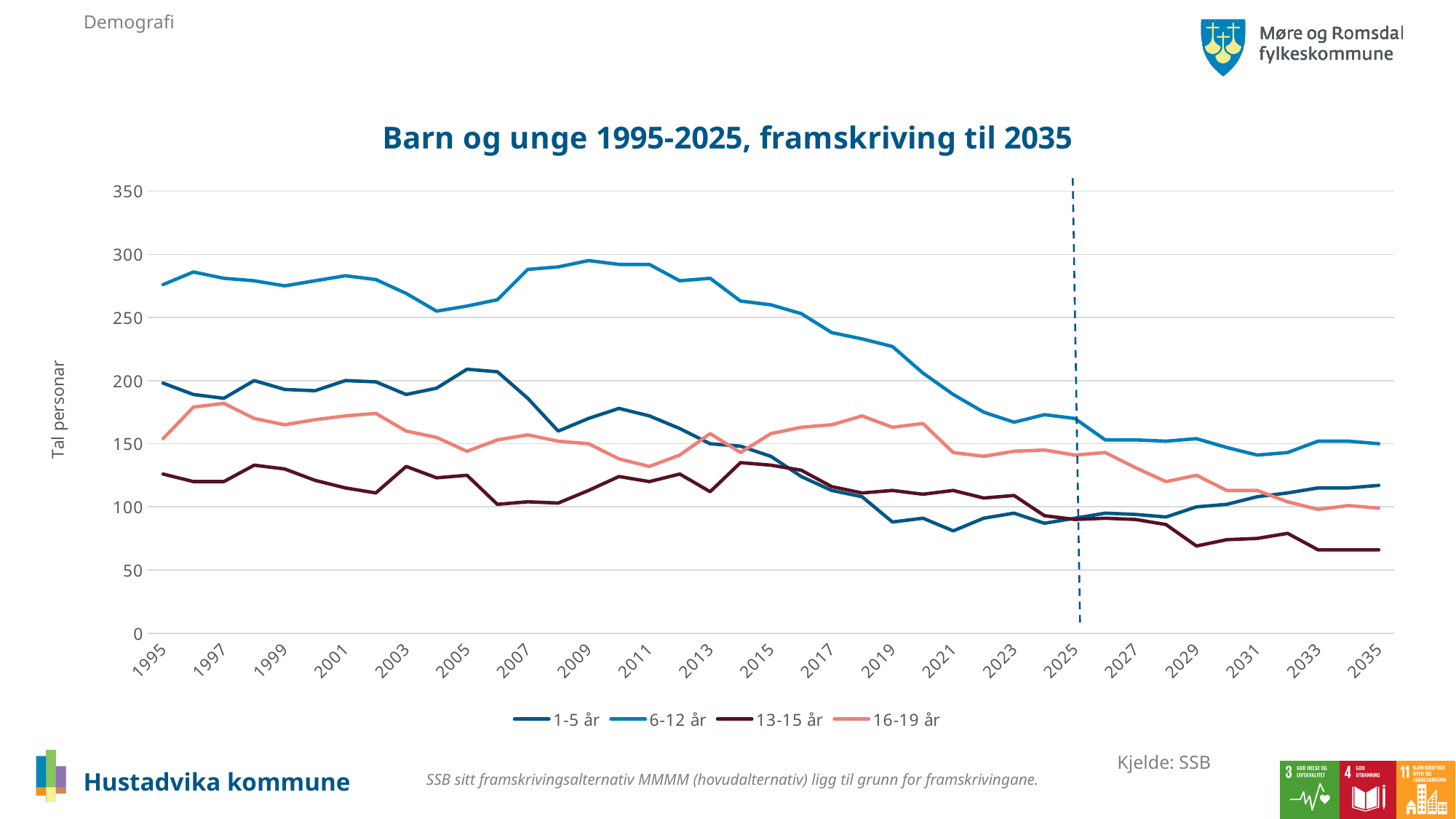
Is the value for 1-5 år in 2021 greater or less than 100? less Which series has the lowest value in 2035? 13-15 år What kind of chart is shown on the slide? line chart How many series does the legend list? 4 In 2009, which series has the higher value, 6-12 år or 1-5 år? 6-12 år Is the value for 16-19 år in 2019 greater or less than 150? greater Is the value for 13-15 år in 2035 greater or less than 100? less Does the 6-12 år series rise or fall between 2009 and 2025? fall Which series has the highest value in 1995? 6-12 år What are the series listed in the legend? 1-5 år, 6-12 år, 13-15 år, 16-19 år What is the title of the chart? Barn og unge 1995-2025, framskriving til 2035